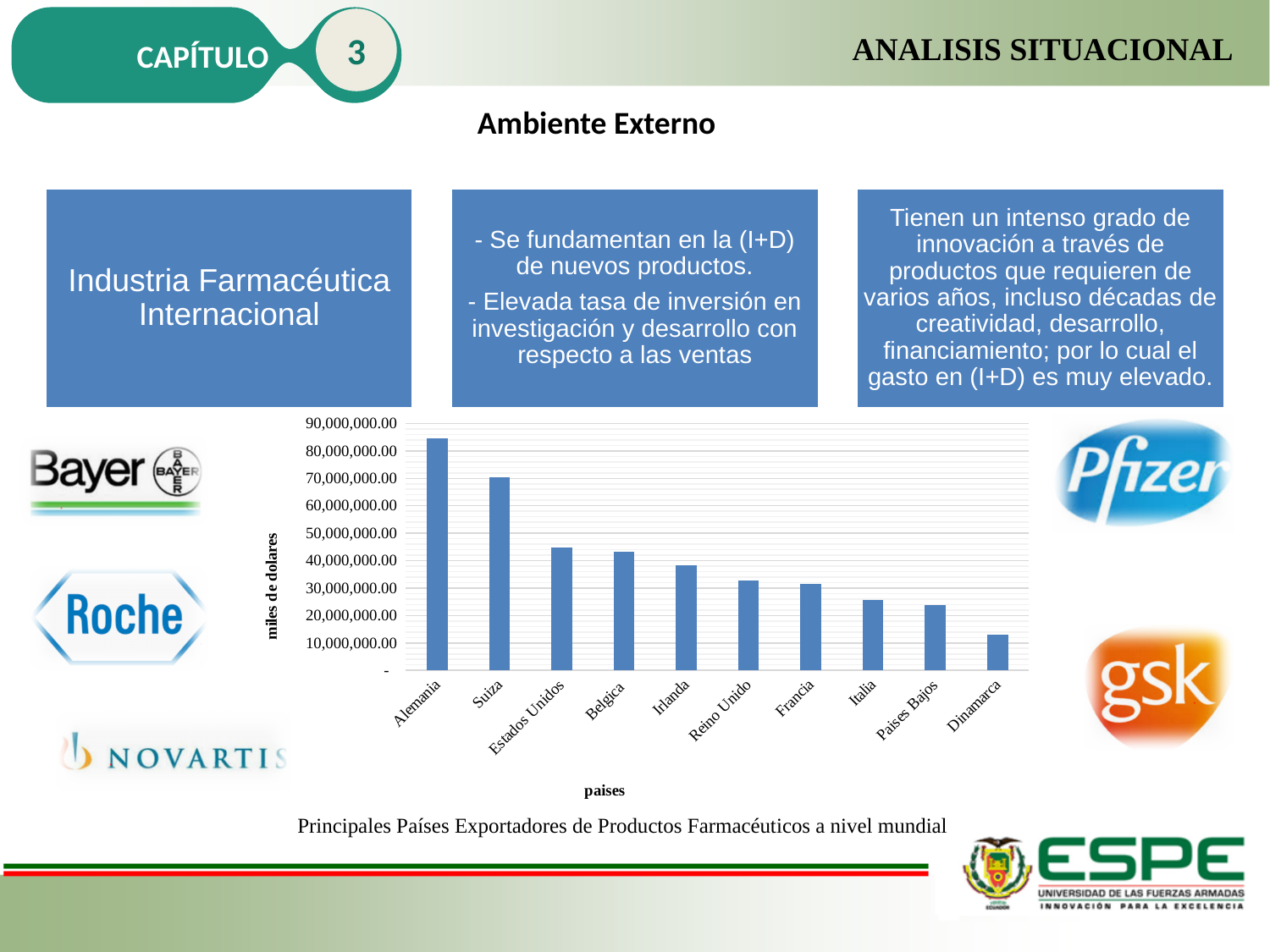
Which has a larger value, Alemania or Suiza? Alemania How many countries are shown on the x axis of the chart? 10 Which country has the highest bar in the chart? Alemania Which has a larger value, Irlanda or Italia? Irlanda Is the value for Alemania greater or less than 80,000,000.00? greater Is the value for Dinamarca greater or less than 20,000,000.00? less Do the bar values rise or fall from left to right along the x axis? fall Is the value for Italia greater or less than 30,000,000.00? less What is the title of the vertical axis of the chart? miles de dolares Which country has the lowest bar in the chart? Dinamarca What kind of chart is shown on the slide? bar chart